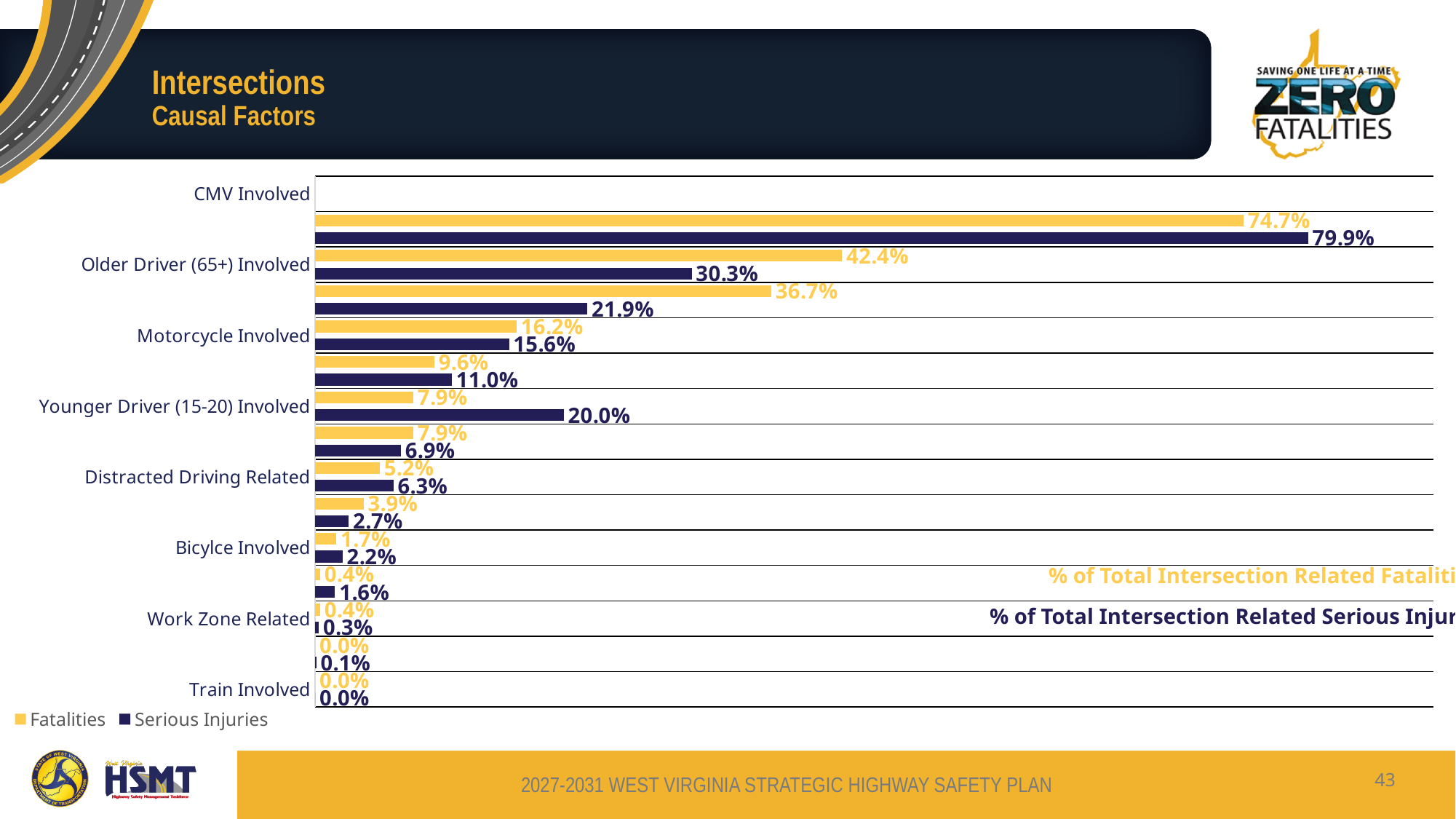
What is the Fatalities value for Older Driver (65+) Involved? 42.4% What is the Fatalities value for Motorcycle Involved? 16.2% What is the Fatalities value for Train Involved? 0.0% What is the Serious Injuries value for Younger Driver (15-20) Involved? 20.0% For Younger Driver (15-20) Involved, which is larger: Fatalities or Serious Injuries? Serious Injuries How many series does the chart legend list? 2 What is the highest Fatalities value labelled on the chart? 74.7% What is the highest Serious Injuries value labelled on the chart? 79.9% What is the difference between the Fatalities and Serious Injuries values for Older Driver (65+) Involved? 12.1% What are the two series named in the chart legend? Fatalities and Serious Injuries What kind of chart is shown on the slide? bar chart What is the Serious Injuries value for Older Driver (65+) Involved? 30.3%